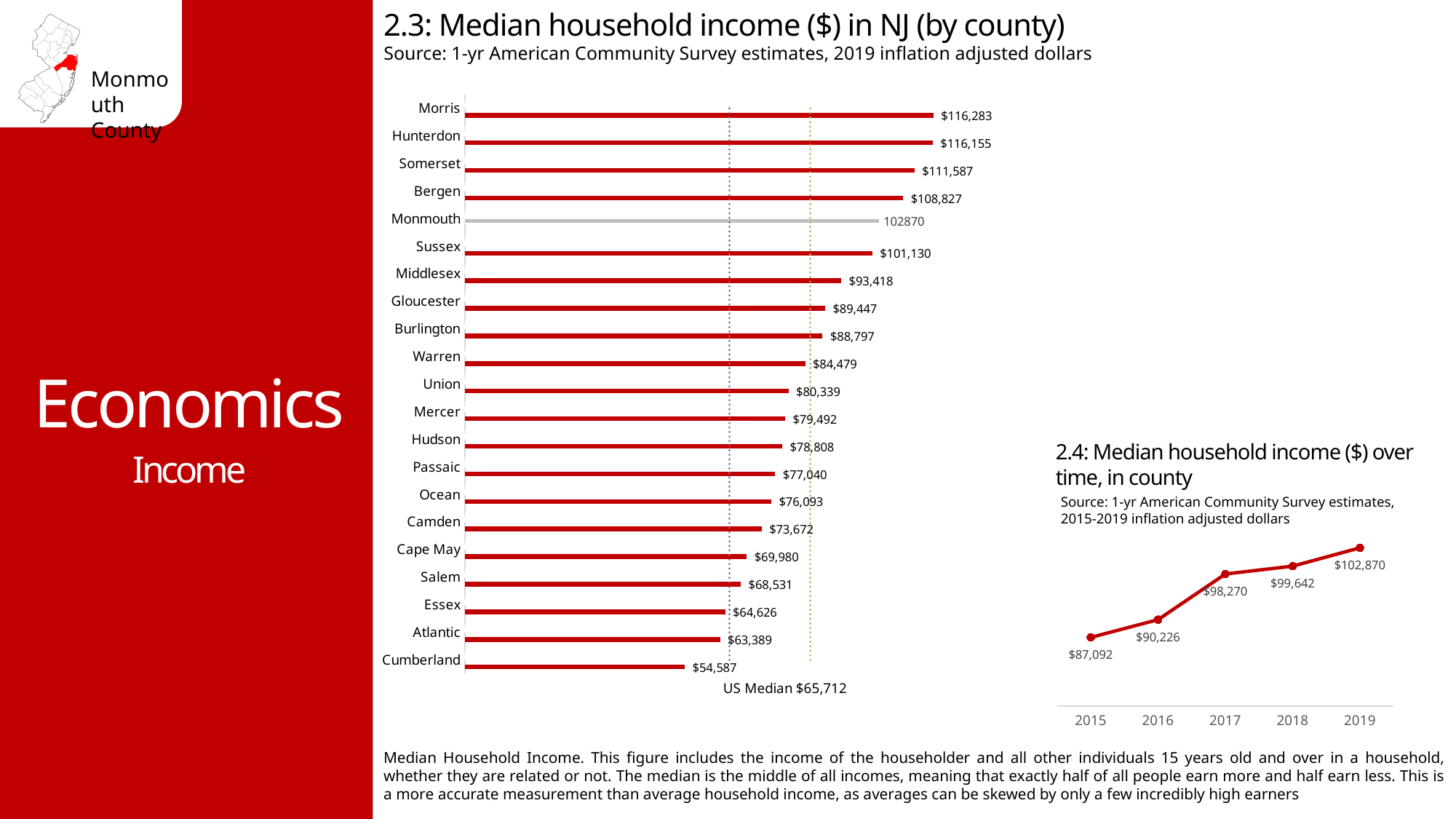
In the chart '2.3: Median household income ($) in NJ (by county)', what is the difference between the values for Morris and Cumberland? $61,696 In the chart '2.3: Median household income ($) in NJ (by county)', which county has a higher median household income, Sussex or Middlesex? Sussex What kind of chart is '2.3: Median household income ($) in NJ (by county)'? Bar chart How many counties are shown in the chart '2.3: Median household income ($) in NJ (by county)'? 21 In the chart '2.3: Median household income ($) in NJ (by county)', what US Median value is noted below the chart? $65,712 In the chart '2.3: Median household income ($) in NJ (by county)', which county has the lowest median household income? Cumberland In the chart '2.4: Median household income ($) over time, in county', does the median household income rise or fall from 2015 to 2019? Rise How many years are plotted in the chart '2.4: Median household income ($) over time, in county'? 5 In the chart '2.3: Median household income ($) in NJ (by county)', what is the median household income for Bergen? $108,827 In the chart '2.4: Median household income ($) over time, in county', what is the difference between the 2019 and 2015 values? $15,778 In the chart '2.4: Median household income ($) over time, in county', what is the median household income for 2017? $98,270 In the chart '2.3: Median household income ($) in NJ (by county)', what is the value shown for Monmouth? 102870